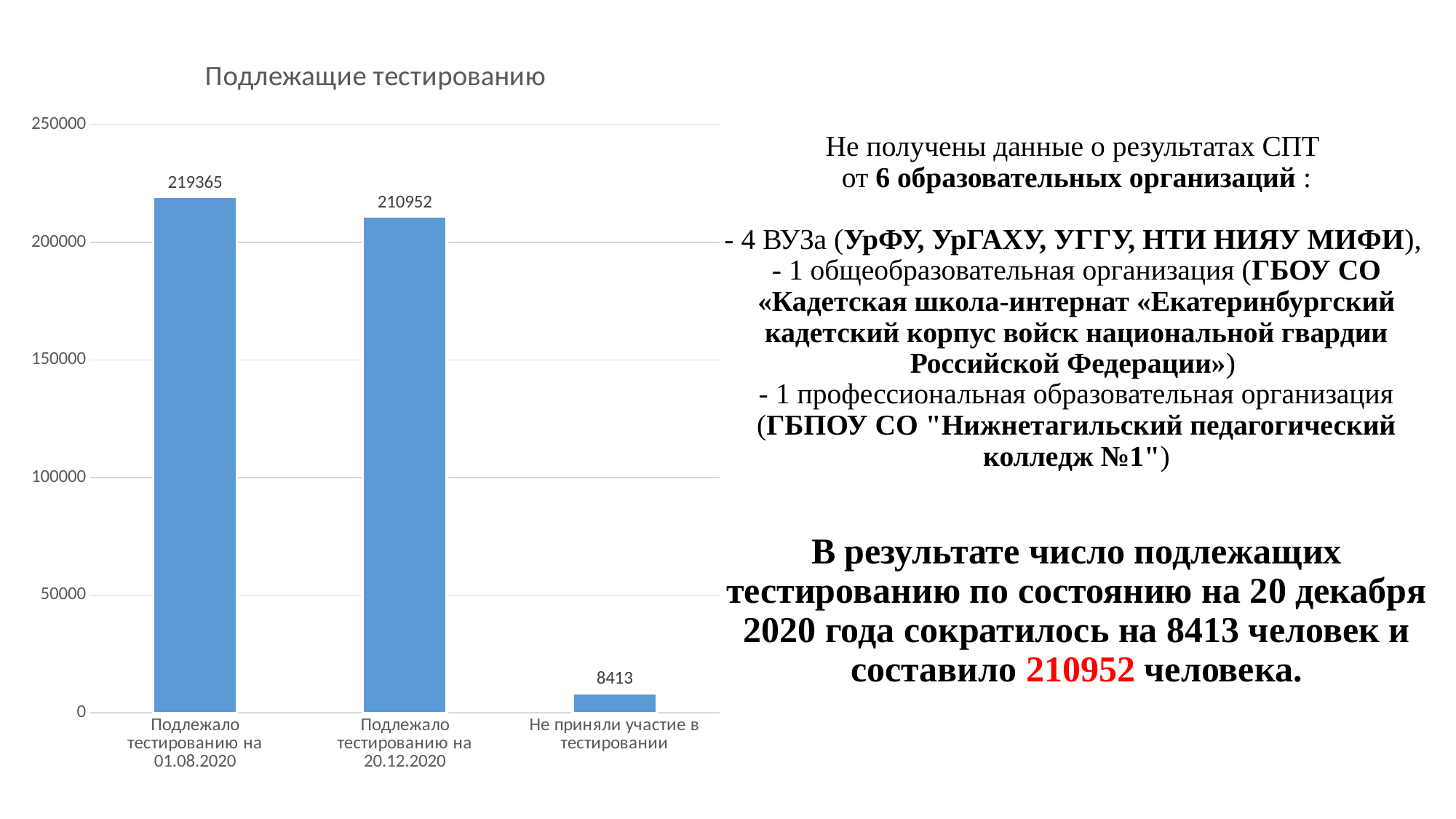
Is the value for "Подлежало тестированию на 20.12.2020" greater or less than 200000? greater Which is larger: the value for "Подлежало тестированию на 01.08.2020" or for "Подлежало тестированию на 20.12.2020"? Подлежало тестированию на 01.08.2020 What is the value for "Подлежало тестированию на 01.08.2020"? 219365 What is the difference between the values for 01.08.2020 and 20.12.2020? 8413 Is the value for "Не приняли участие в тестировании" greater or less than 50000? less What kind of chart is shown on the slide? bar chart What is the value for "Подлежало тестированию на 20.12.2020"? 210952 Which category has the lowest value? Не приняли участие в тестировании Which category has the highest value? Подлежало тестированию на 01.08.2020 What is the value for "Не приняли участие в тестировании"? 8413 What is the title of the chart? Подлежащие тестированию How many categories are shown in the chart? 3